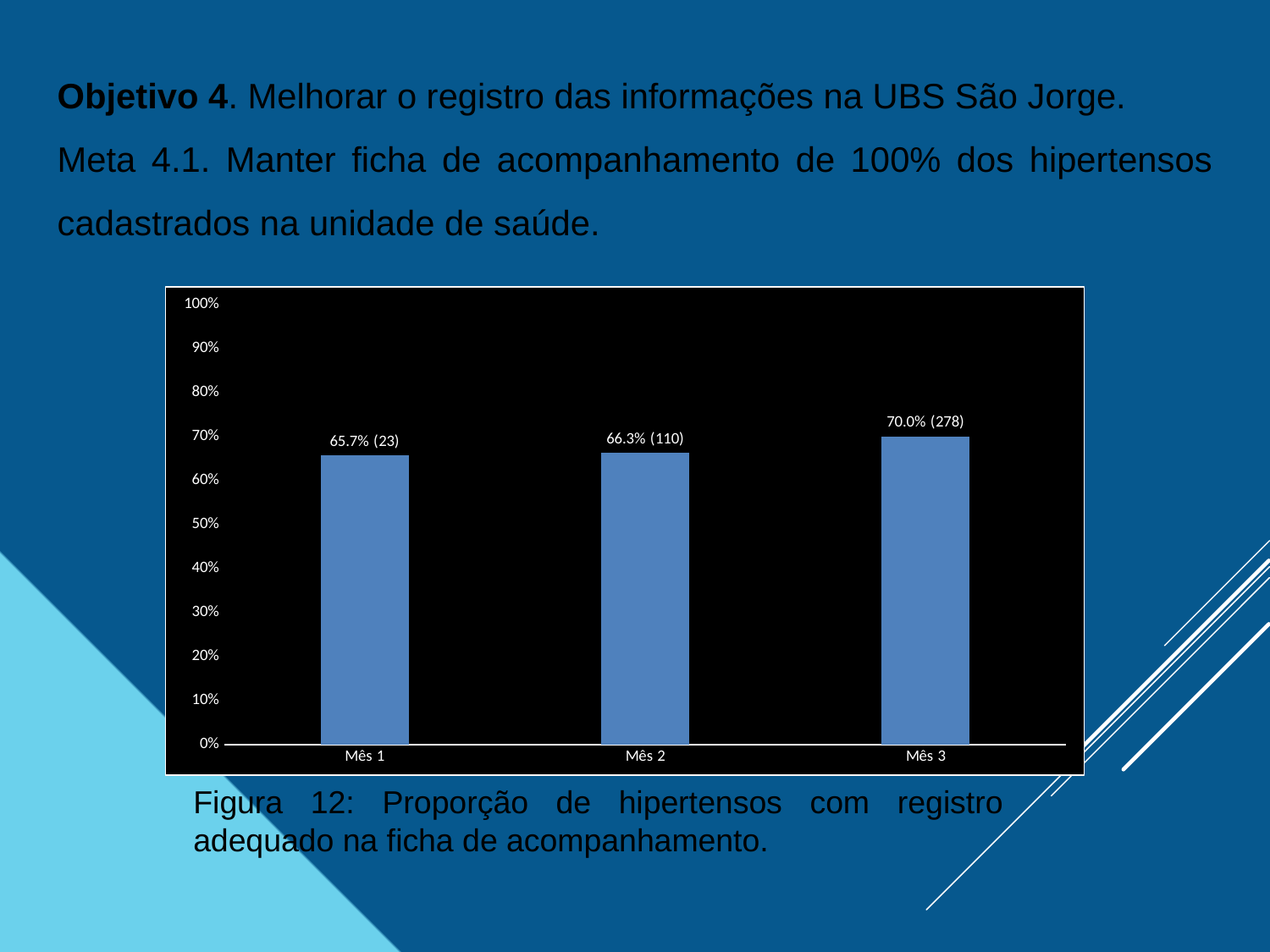
What is the value shown for Mês 1? 65.7% (23) How many months are shown on the x axis? 3 What is the value shown for Mês 2? 66.3% (110) Do the values rise or fall from Mês 1 to Mês 3? rise What is the difference in percentage points between Mês 3 and Mês 2? 3.7 What is the value shown for Mês 3? 70.0% (278) Which is larger, the value for Mês 2 or the value for Mês 1? Mês 2 Which month has the highest proportion? Mês 3 What is the difference in percentage points between Mês 3 and Mês 1? 4.3 Which month has the lowest proportion? Mês 1 What kind of chart is shown on the slide? bar chart Is the value for Mês 3 greater or less than 80%? less